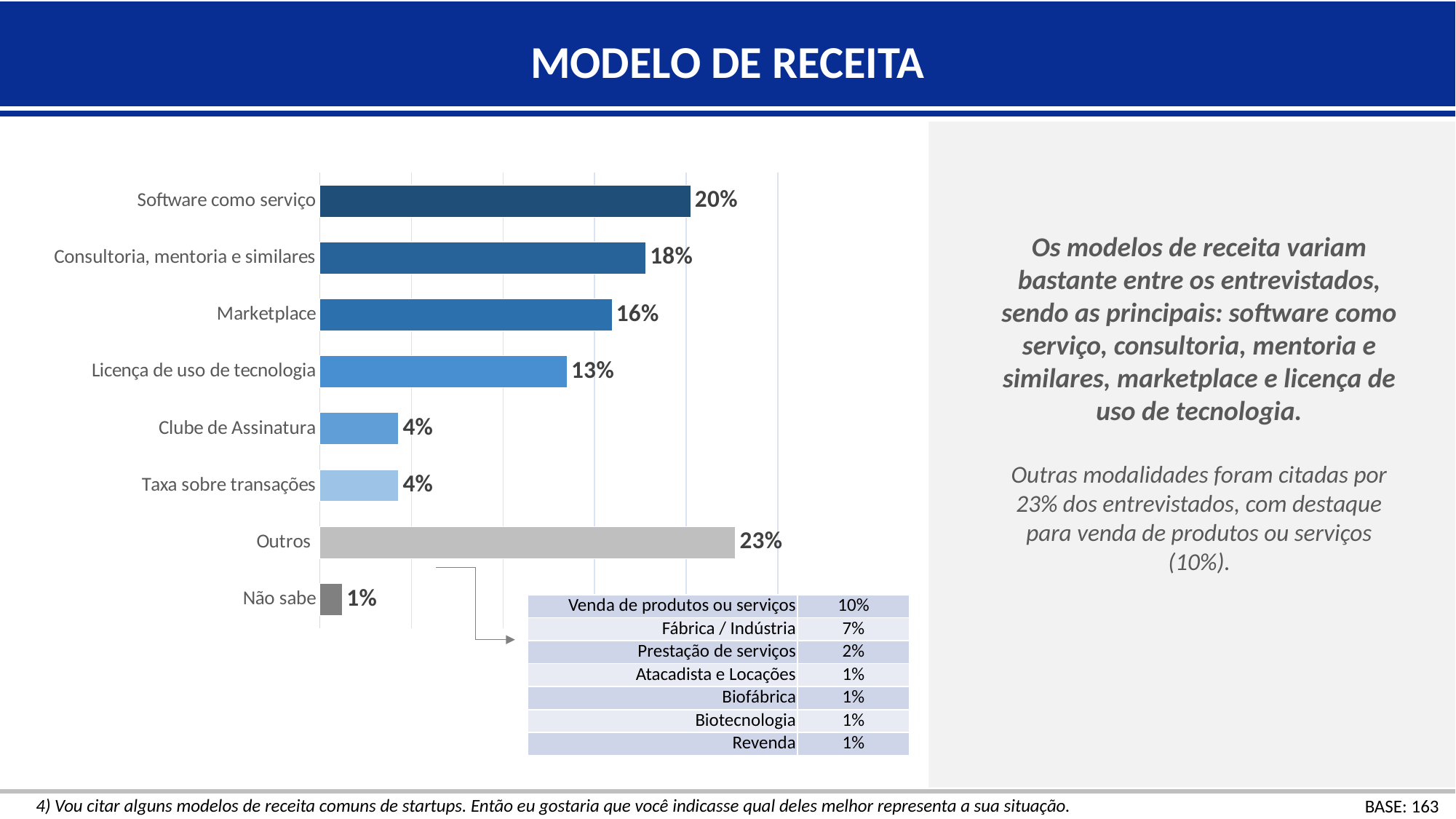
What kind of chart is shown on the slide? Bar chart What is the value for Software como serviço? 20% What is the value for Marketplace? 16% What is the difference between Outros and Licença de uso de tecnologia? 10% How many categories are shown in the bar chart? 8 Which category has the highest value in the chart? Outros What is the value for Licença de uso de tecnologia? 13% What is the value for Não sabe? 1% Which is larger, Marketplace or Clube de Assinatura? Marketplace What is the title of the slide containing the chart? MODELO DE RECEITA What is the difference between Software como serviço and Consultoria, mentoria e similares? 2% Which category has the lowest value in the chart? Não sabe